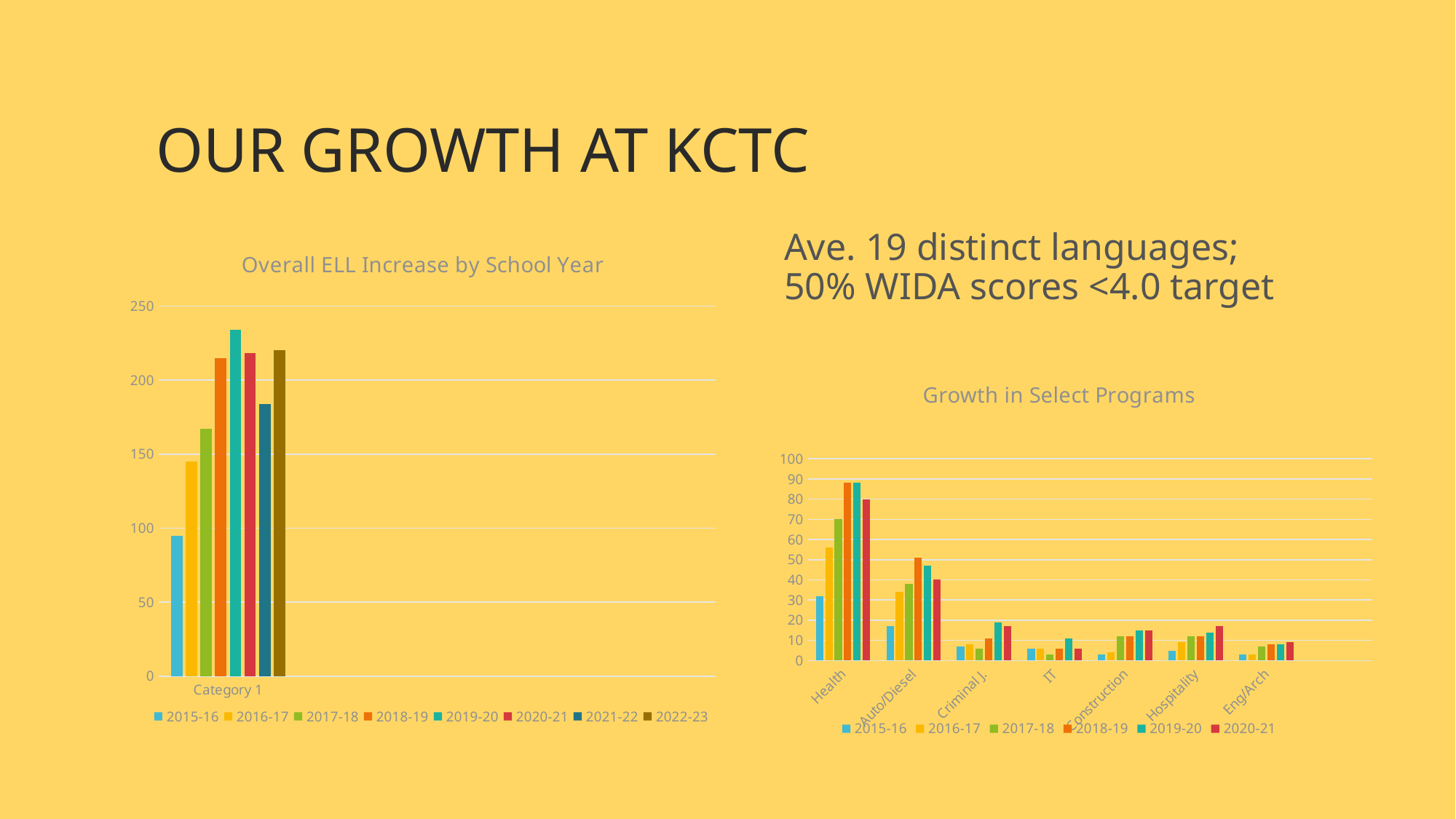
In the 'Growth in Select Programs' chart, which program has the highest bars overall? Health In the 'Growth in Select Programs' chart, is the 2015-16 value for Health greater or less than 50? less How many series does the legend of the 'Growth in Select Programs' chart list? 6 What kind of chart is the 'Overall ELL Increase by School Year' chart? bar chart In the 'Overall ELL Increase by School Year' chart, is the value for 2015-16 greater or less than 100? less In the 'Overall ELL Increase by School Year' chart, which is larger, the value for 2017-18 or the value for 2021-22? 2021-22 In the 'Overall ELL Increase by School Year' chart, which school year has the highest bar? 2019-20 How many series does the legend of the 'Overall ELL Increase by School Year' chart list? 8 How many program categories are shown on the x axis of the 'Growth in Select Programs' chart? 7 In the 'Overall ELL Increase by School Year' chart, is the value for 2019-20 greater or less than 200? greater In the 'Overall ELL Increase by School Year' chart, which school year has the lowest bar? 2015-16 In the 'Growth in Select Programs' chart, which is larger, the 2018-19 value for Health or the 2018-19 value for Auto/Diesel? Health